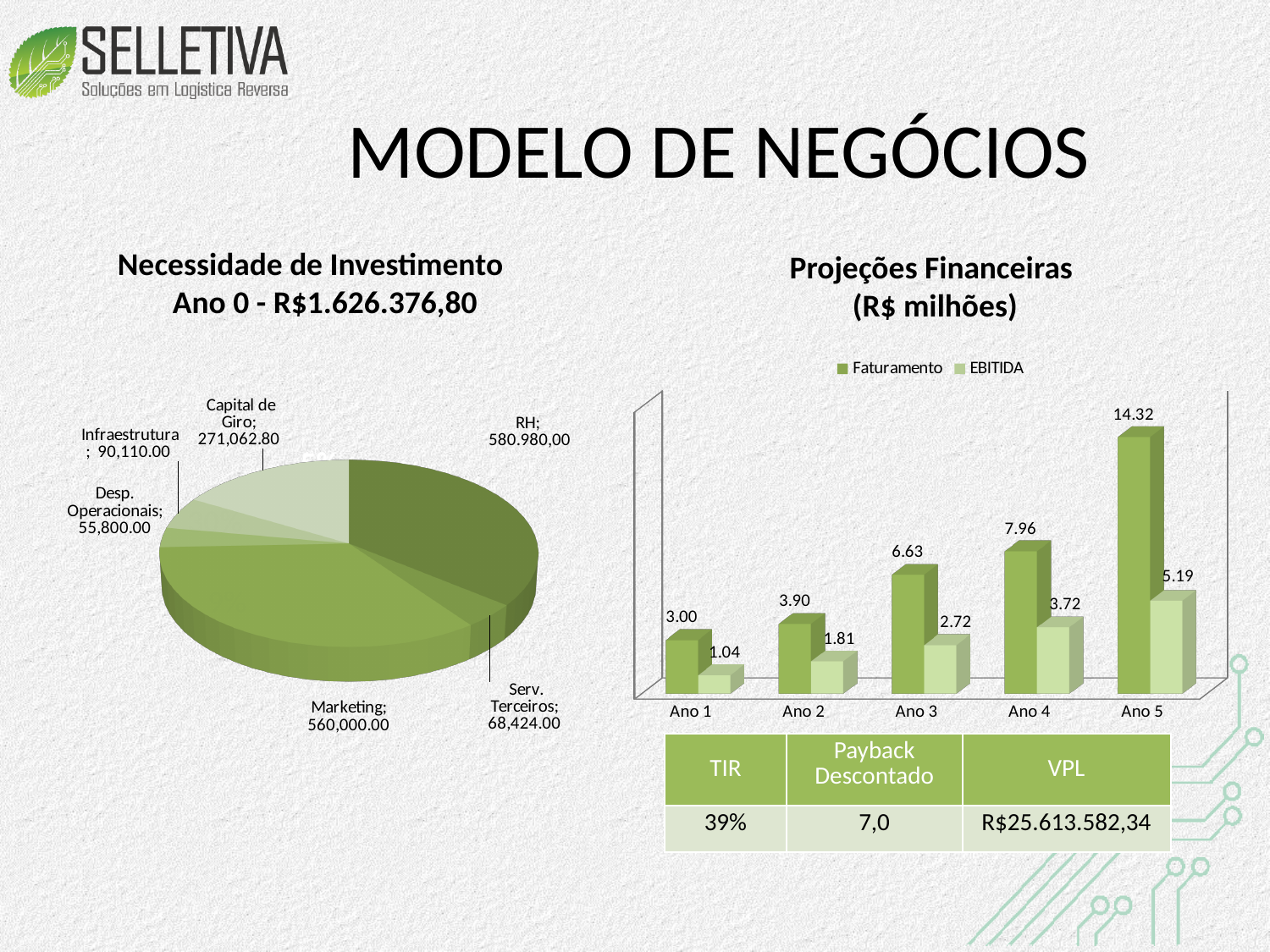
In the 'Projeções Financeiras' chart, what is the difference between Faturamento and EBITIDA in Ano 5? 9.13 In the 'Necessidade de Investimento' pie chart, what is the value for Marketing? 560,000.00 In the 'Necessidade de Investimento' pie chart, what is the value for Capital de Giro? 271,062.80 In the 'Projeções Financeiras' chart, does EBITIDA rise or fall from Ano 1 to Ano 5? Rise What kind of chart is the 'Projeções Financeiras' chart on the right? Bar chart In the 'Projeções Financeiras' chart, what is the Faturamento value for Ano 3? 6.63 How many series does the legend of the 'Projeções Financeiras' chart list? 2 What kind of chart is the 'Necessidade de Investimento' chart on the left? Pie chart In the 'Projeções Financeiras' chart, what is the EBITIDA value for Ano 5? 5.19 In the 'Projeções Financeiras' chart, which year has the highest Faturamento? Ano 5 In the 'Necessidade de Investimento' pie chart, which category has the smallest value? Desp. Operacionais How many categories does the 'Necessidade de Investimento' pie chart show? 6